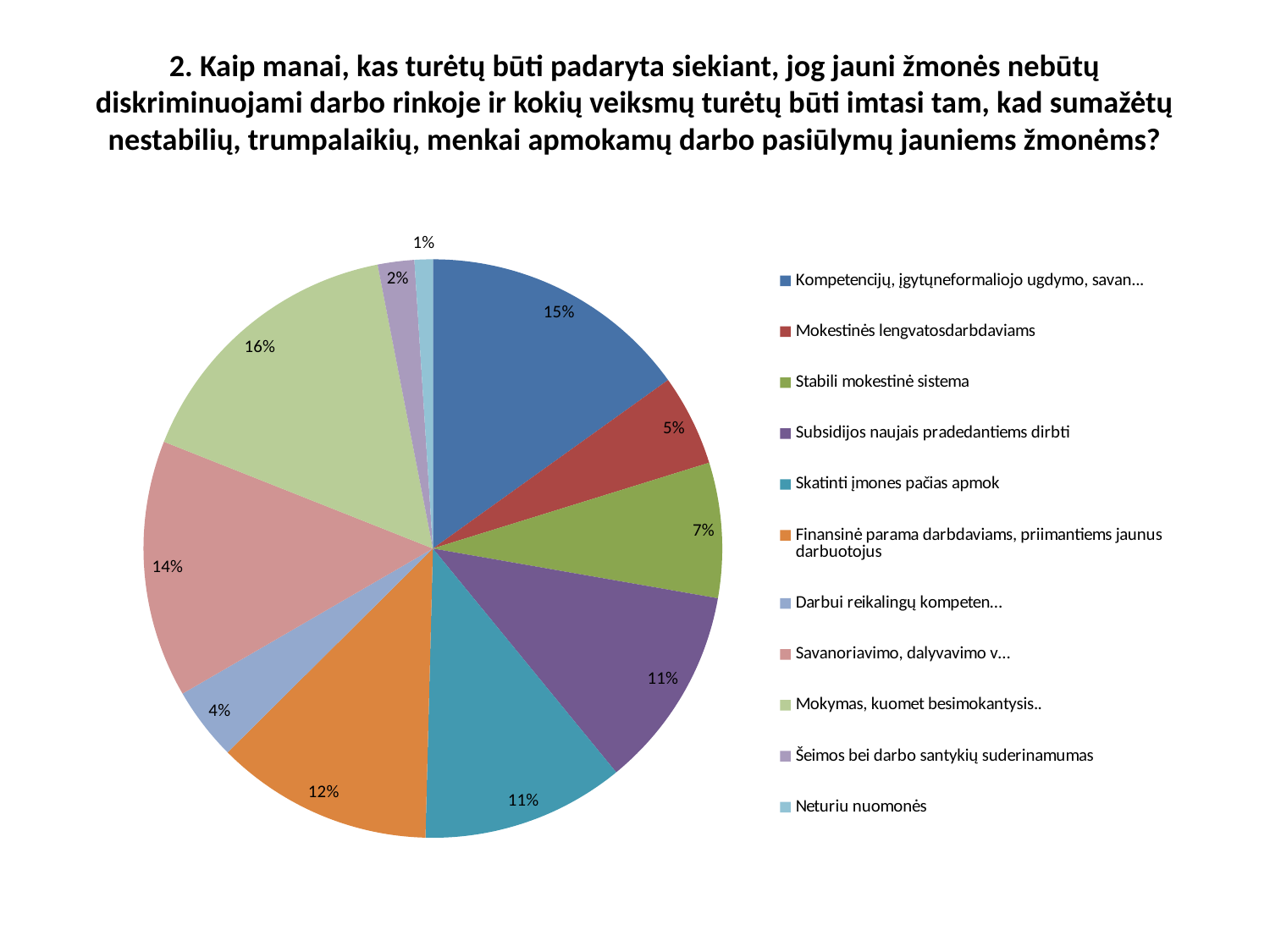
What share of the pie does "Stabili mokestinė sistema" represent? 7% What kind of chart is shown on the slide? pie chart Which category has the smallest slice of the pie? Neturiu nuomonės What share of the pie does "Šeimos bei darbo santykių suderinamumas" represent? 2% What share of the pie does "Mokestinės lengvatosdarbdaviams" represent? 5% How many slices does the pie chart have? 11 Which is larger: the slice for "Skatinti įmones pačias apmok" or the slice for "Mokestinės lengvatosdarbdaviams"? Skatinti įmones pačias apmok Which category has the largest slice of the pie? Mokymas, kuomet besimokantysis.. What colour is the slice for "Neturiu nuomonės"? light blue What is the difference in percentage points between "Finansinė parama darbdaviams, priimantiems jaunus darbuotojus" and "Stabili mokestinė sistema"? 5%